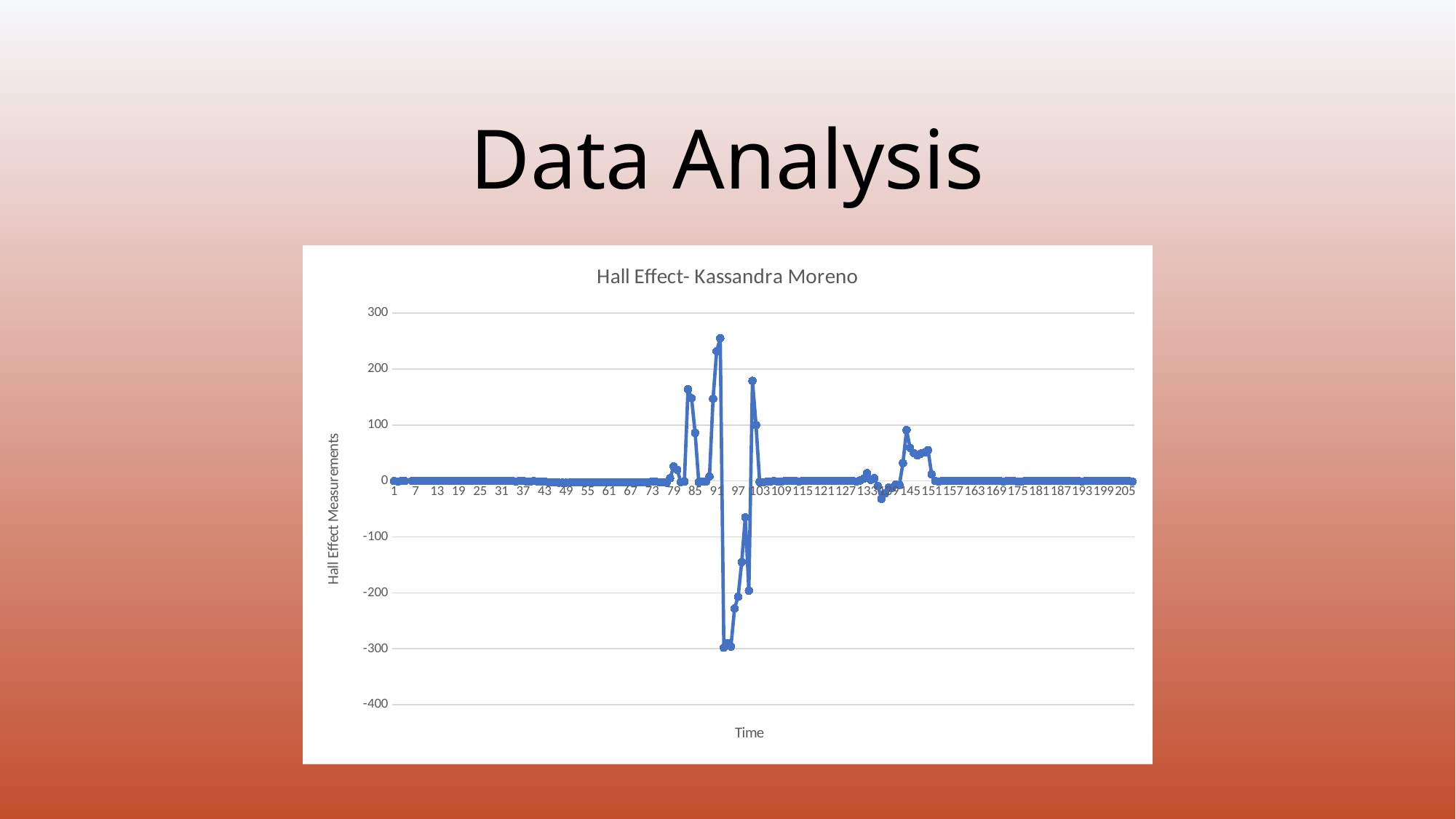
Is the lowest value plotted on the chart greater or less than -200? less What kind of chart is shown on the slide? line chart What is the title of the chart? Hall Effect- Kassandra Moreno Is the peak value near time 103 greater or less than 100? greater Is the value at time 1 greater or less than 100? less What is the label of the vertical axis? Hall Effect Measurements